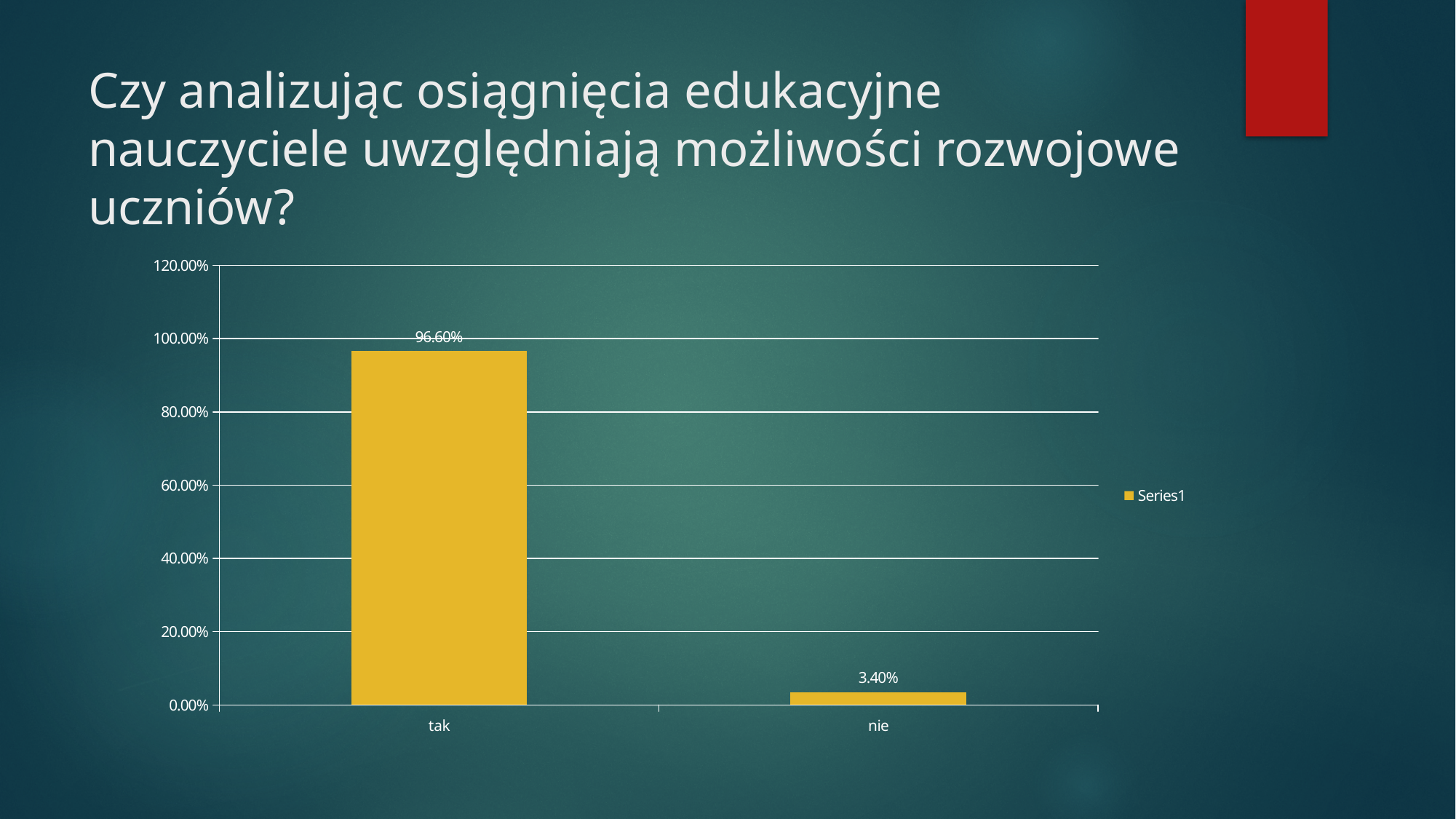
What kind of chart is shown on the slide? bar chart Which is larger, the value for "tak" or the value for "nie"? tak How many categories are shown on the x axis? 2 Which category has the highest value? tak What is the name of the series shown in the legend? Series1 Is the value for "nie" greater or less than 20.00%? less How many series does the legend list? 1 Is the value for "tak" greater or less than 80.00%? greater Which category has the lowest value? nie What is the value for "nie"? 3.40% What is the value for "tak"? 96.60% What is the difference between the values for "tak" and "nie"? 93.20%